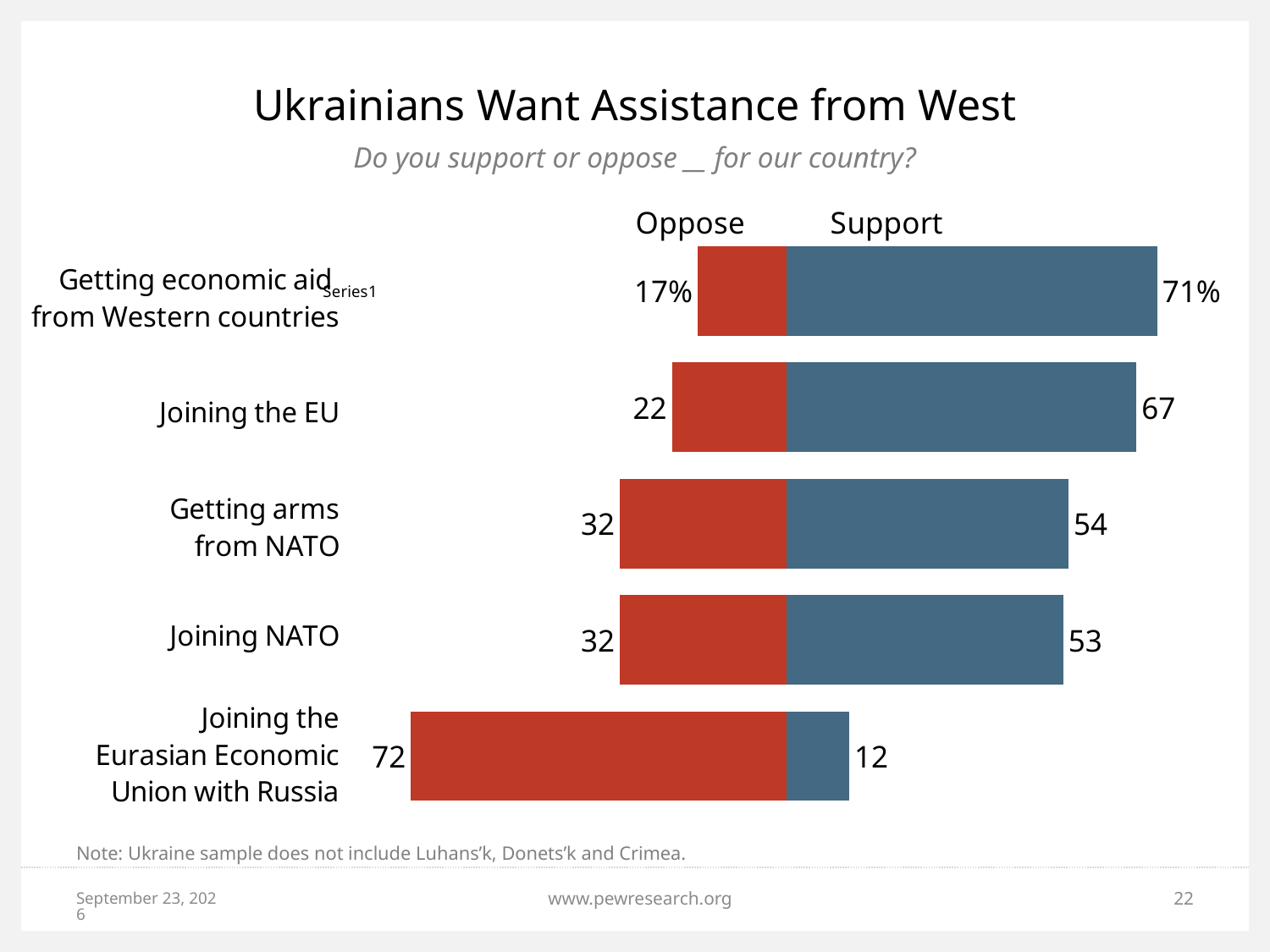
Which is larger: the Oppose value for joining the EU or the Oppose value for joining NATO? Joining NATO How many series does the chart show? 2 What share of Ukrainians oppose joining the EU? 22 What is the Support value for joining the Eurasian Economic Union with Russia? 12 What type of chart is shown on the slide? Bar chart What share of Ukrainians support getting economic aid from Western countries? 71% What is the Oppose value for getting arms from NATO? 32 What is the difference between the Support values for joining the EU and joining NATO? 14 How many items are shown in the chart? 5 Which item has the highest Support value? Getting economic aid from Western countries Which item has the lowest Support value? Joining the Eurasian Economic Union with Russia Which item has the highest Oppose value? Joining the Eurasian Economic Union with Russia